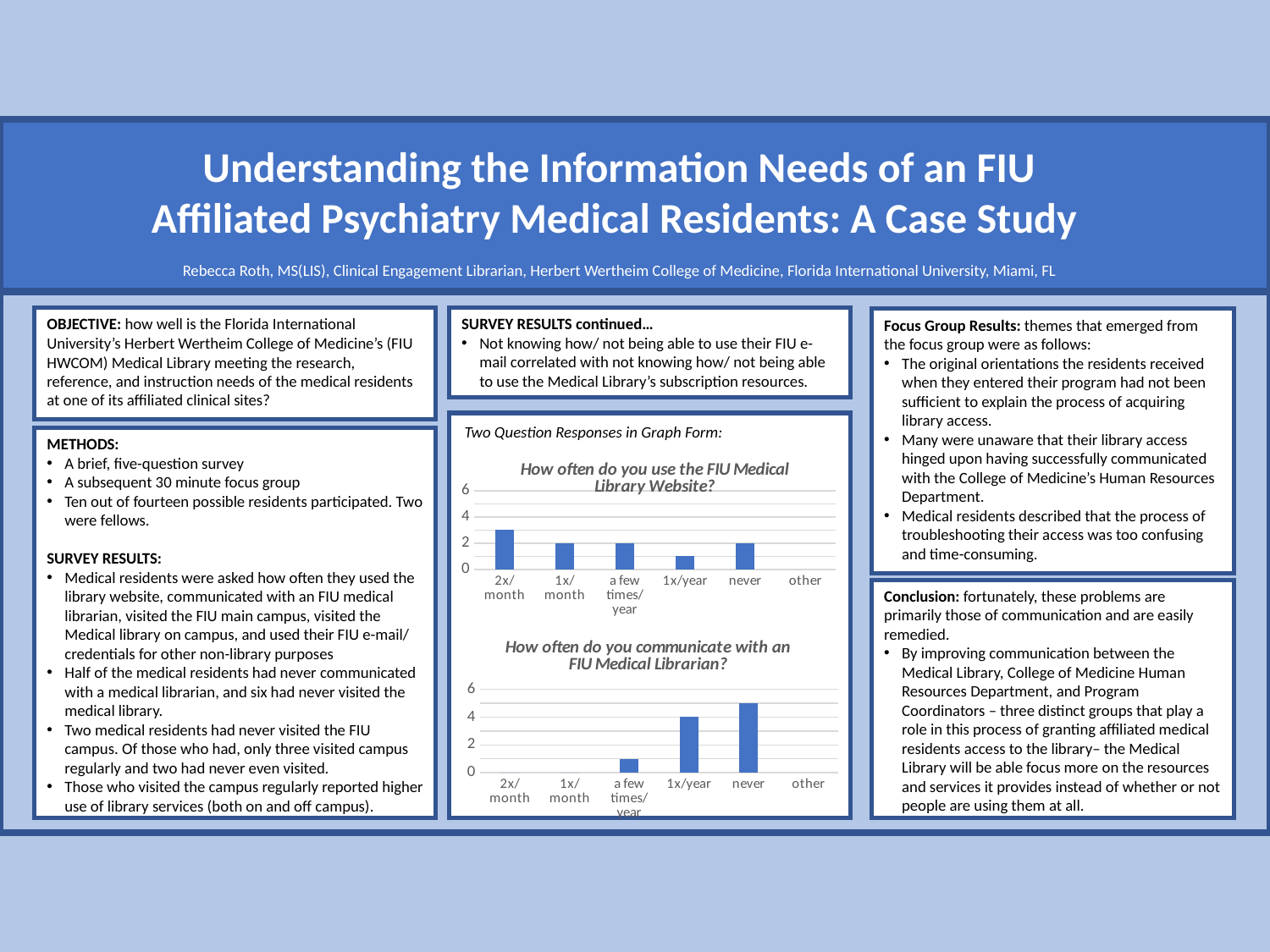
In the chart titled "How often do you communicate with an FIU Medical Librarian?", what is the value for "1x/year"? 4 In the chart titled "How often do you use the FIU Medical Library Website?", is the value for "2x/month" greater or less than 2? greater How many categories are shown on the x axis of the chart titled "How often do you communicate with an FIU Medical Librarian?"? 6 In the chart titled "How often do you use the FIU Medical Library Website?", what is the value for "1x/month"? 2 In the chart titled "How often do you communicate with an FIU Medical Librarian?", which is larger, the value for "never" or the value for "1x/year"? never In the chart titled "How often do you use the FIU Medical Library Website?", which category has the highest value? 2x/month In the chart titled "How often do you use the FIU Medical Library Website?", which is larger, the value for "2x/month" or the value for "1x/year"? 2x/month In the chart titled "How often do you use the FIU Medical Library Website?", what is the value for "never"? 2 What kind of chart is the chart titled "How often do you use the FIU Medical Library Website?"? bar chart In the chart titled "How often do you communicate with an FIU Medical Librarian?", is the value for "never" greater or less than 4? greater In the chart titled "How often do you communicate with an FIU Medical Librarian?", which category has the highest value? never In the chart titled "How often do you use the FIU Medical Library Website?", is the value for "1x/year" greater or less than 2? less